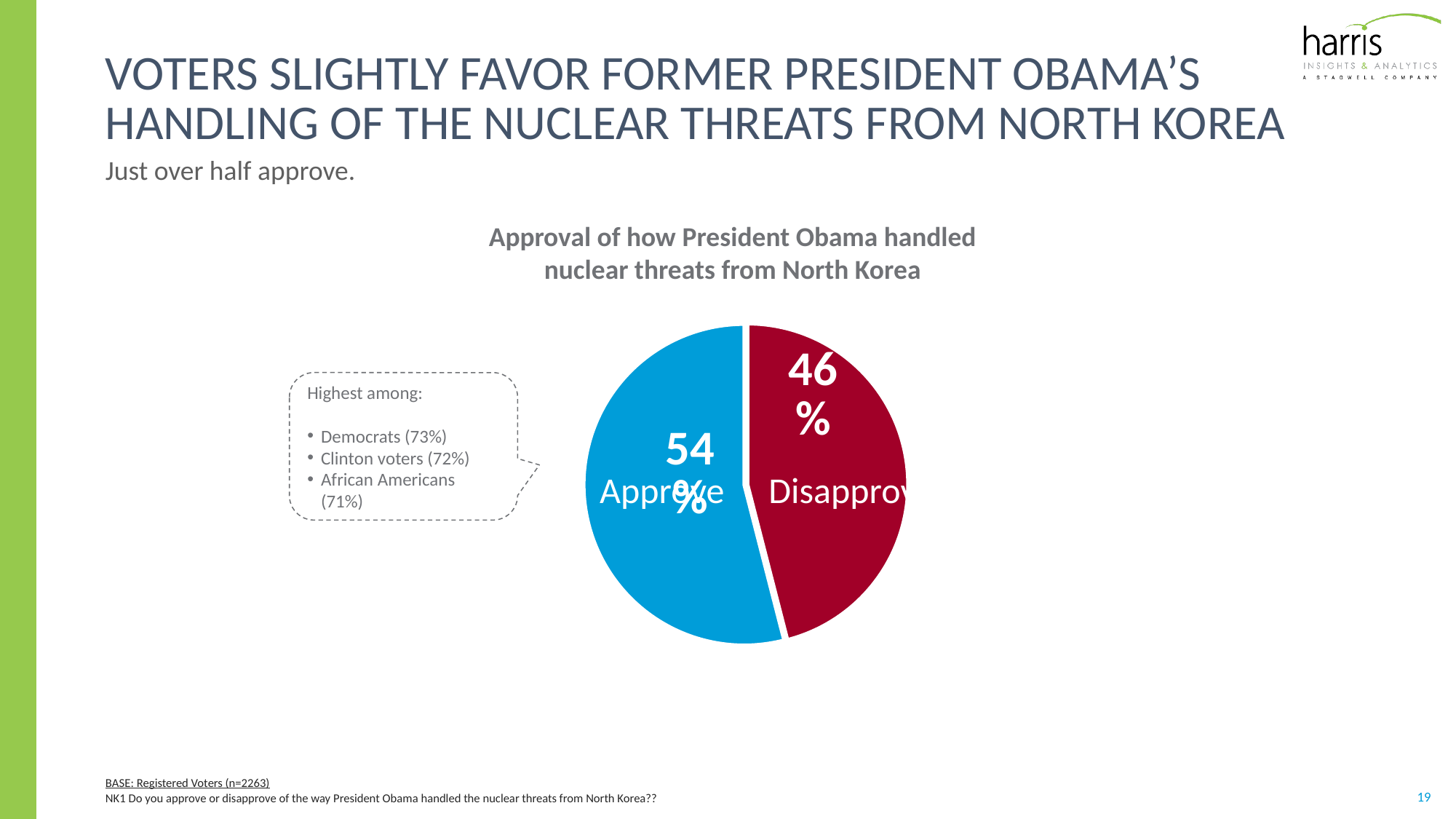
What is the title of the pie chart? Approval of how President Obama handled nuclear threats from North Korea How many slices does the pie chart have? 2 What kind of chart is shown on the slide? pie chart What is the difference in percentage points between Approve and Disapprove? 8 What colour is the Disapprove slice of the pie? red What is the total of the Approve and Disapprove shares? 100% What percentage of voters approve of how President Obama handled nuclear threats from North Korea? 54% Which response has the smallest share of the pie? Disapprove Which slice of the pie is larger, Approve or Disapprove? Approve Is the Approve share greater or less than 50%? greater What percentage of voters disapprove of how President Obama handled nuclear threats from North Korea? 46%